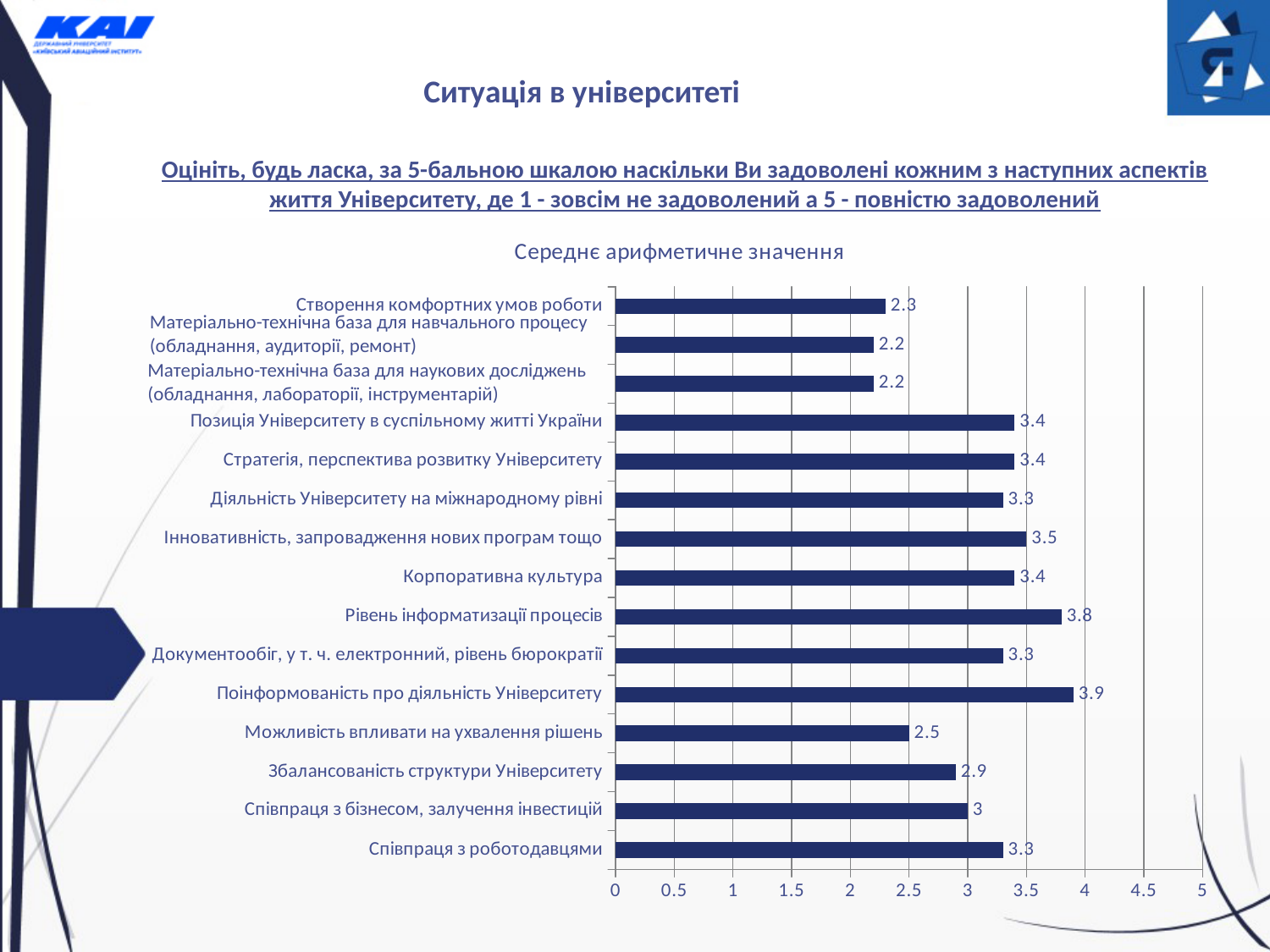
What is the title of the chart? Середнє арифметичне значення What is the value for "Можливість впливати на ухвалення рішень"? 2.5 What is the value for "Створення комфортних умов роботи"? 2.3 What is the value for "Рівень інформатизації процесів"? 3.8 Which is larger: the value for "Інновативність, запровадження нових програм тощо" or the value for "Діяльність Університету на міжнародному рівні"? Інновативність, запровадження нових програм тощо What is the value for "Співпраця з бізнесом, залучення інвестицій"? 3 Is the value for "Збалансованість структури Університету" greater or less than 3? less Which category has the highest value? Поінформованість про діяльність Університету What is the maximum value shown on the horizontal axis? 5 How many categories are shown in the chart? 15 What type of chart is shown on the slide? bar chart What is the difference between the values for "Поінформованість про діяльність Університету" and "Збалансованість структури Університету"? 1